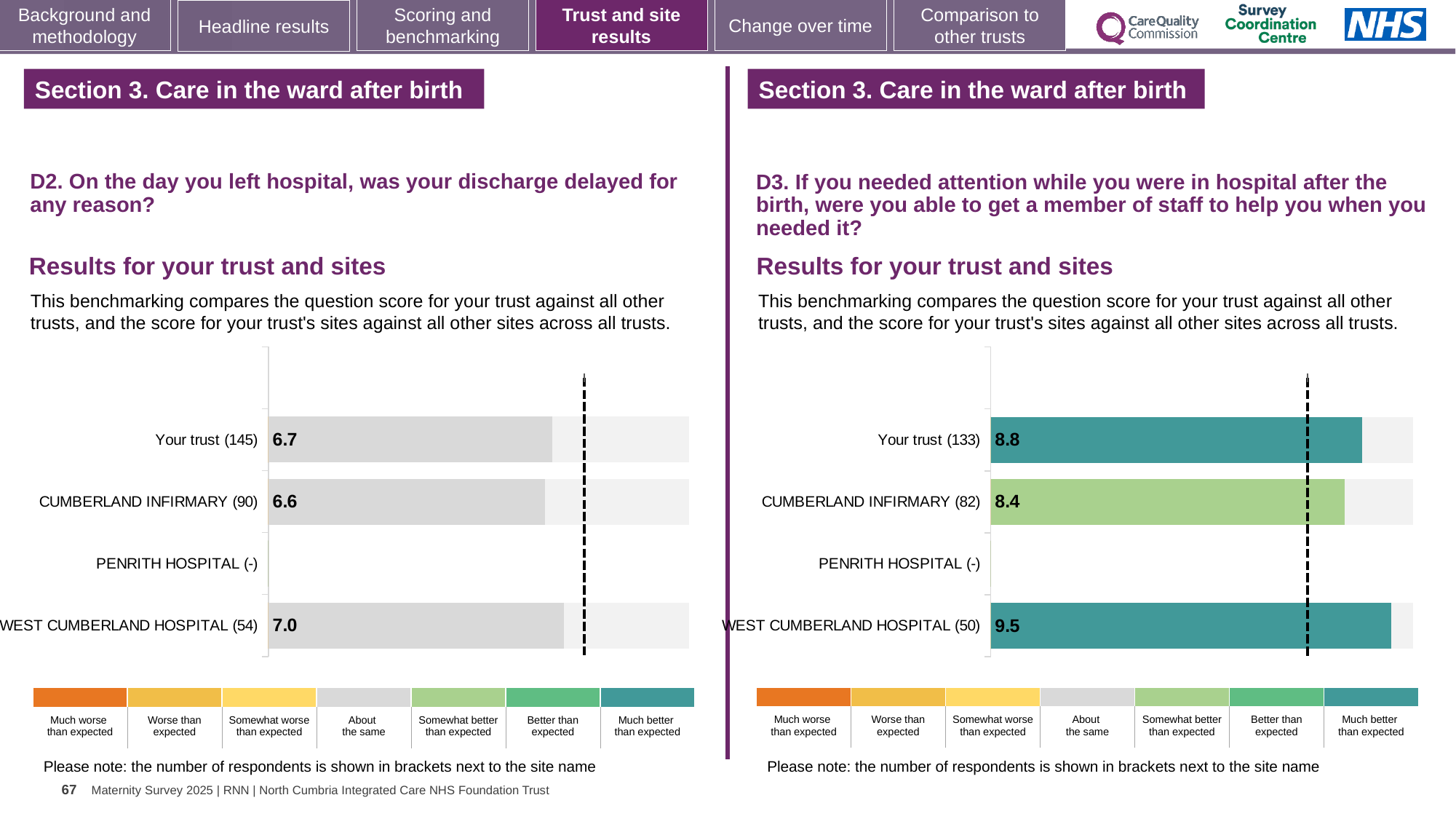
In the right chart (D3), which site or trust row has the highest score? WEST CUMBERLAND HOSPITAL In the left chart (D2), how many respondents are shown in brackets for WEST CUMBERLAND HOSPITAL? 54 In the right chart (D3), what is the difference between the scores for WEST CUMBERLAND HOSPITAL and CUMBERLAND INFIRMARY? 1.1 What kind of chart is used on the right side of the slide (D3)? Bar chart In the right chart (D3), which row with a plotted bar has the lowest score? CUMBERLAND INFIRMARY In the left chart (D2), which is larger: the score for Your trust or the score for CUMBERLAND INFIRMARY? Your trust In the left chart (D2, discharge delayed), what is the score for Your trust? 6.7 In the right chart (D3), which benchmark category does the colour of the Your trust bar correspond to in the legend? Much better than expected In the right chart (D3, able to get a member of staff to help), what is the score for Your trust? 8.8 In the right chart (D3, able to get a member of staff to help), what is the score for WEST CUMBERLAND HOSPITAL? 9.5 In the left chart (D2, discharge delayed), what is the score for CUMBERLAND INFIRMARY? 6.6 In the left chart (D2, discharge delayed), what is the score for WEST CUMBERLAND HOSPITAL? 7.0